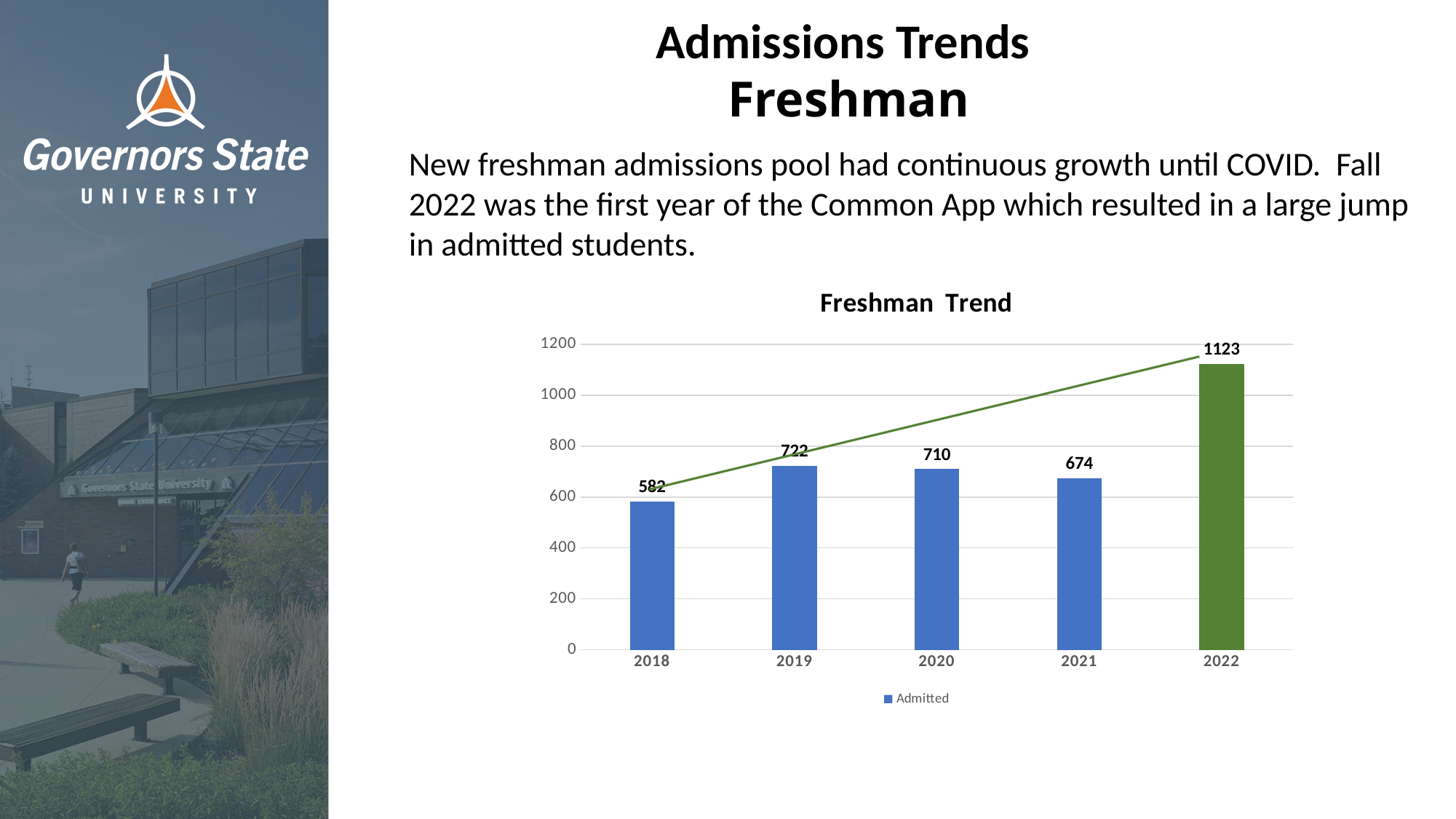
What is the number of admitted freshmen in 2022? 1123 What kind of chart is the Freshman Trend chart? bar chart Which year had more admitted freshmen, 2019 or 2021? 2019 What is the difference between the admitted freshmen in 2022 and 2021? 449 What is the title of the chart? Freshman Trend What is the difference between the admitted freshmen in 2019 and 2018? 140 Which year has the highest number of admitted freshmen? 2022 Which year has the lowest number of admitted freshmen? 2018 How many years are shown on the x axis of the chart? 5 Is the value for 2021 greater or less than 600? greater What is the number of admitted freshmen in 2018? 582 What is the number of admitted freshmen in 2020? 710